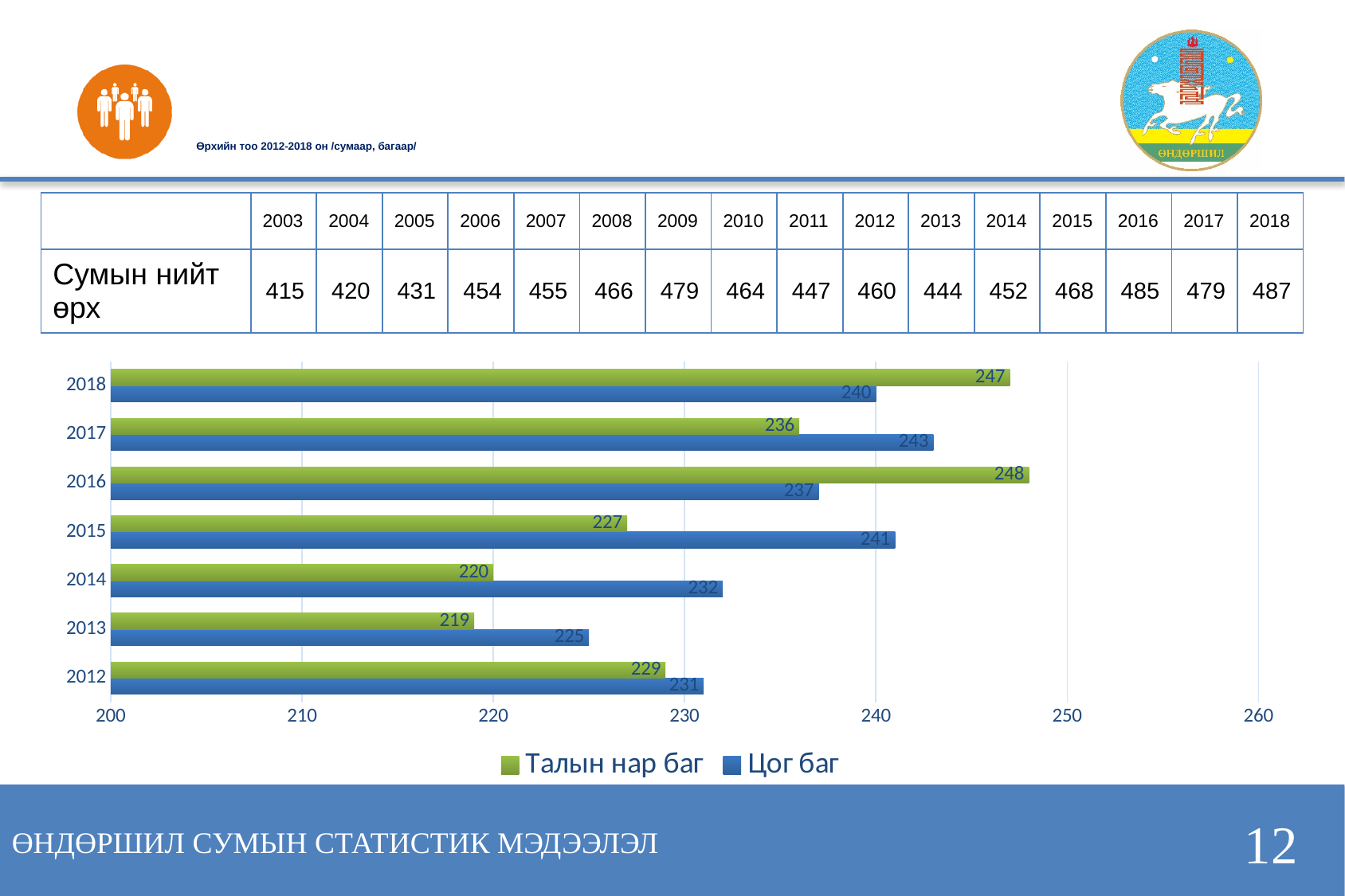
In which year is the value for Талын нар баг lowest? 2013 What is the difference between Талын нар баг and Цог баг in 2014? 12 Which is larger in 2015, Талын нар баг or Цог баг? Цог баг How many years are shown on the chart? 7 What is the value for Талын нар баг in 2016? 248 What is the value for Цог баг in 2015? 241 Which is larger in 2018, Талын нар баг or Цог баг? Талын нар баг How many series does the chart legend list? 2 What kind of chart is shown on the slide? bar chart What is the value for Талын нар баг in 2013? 219 In which year is the value for Цог баг highest? 2017 Which colour represents Цог баг in the chart? blue